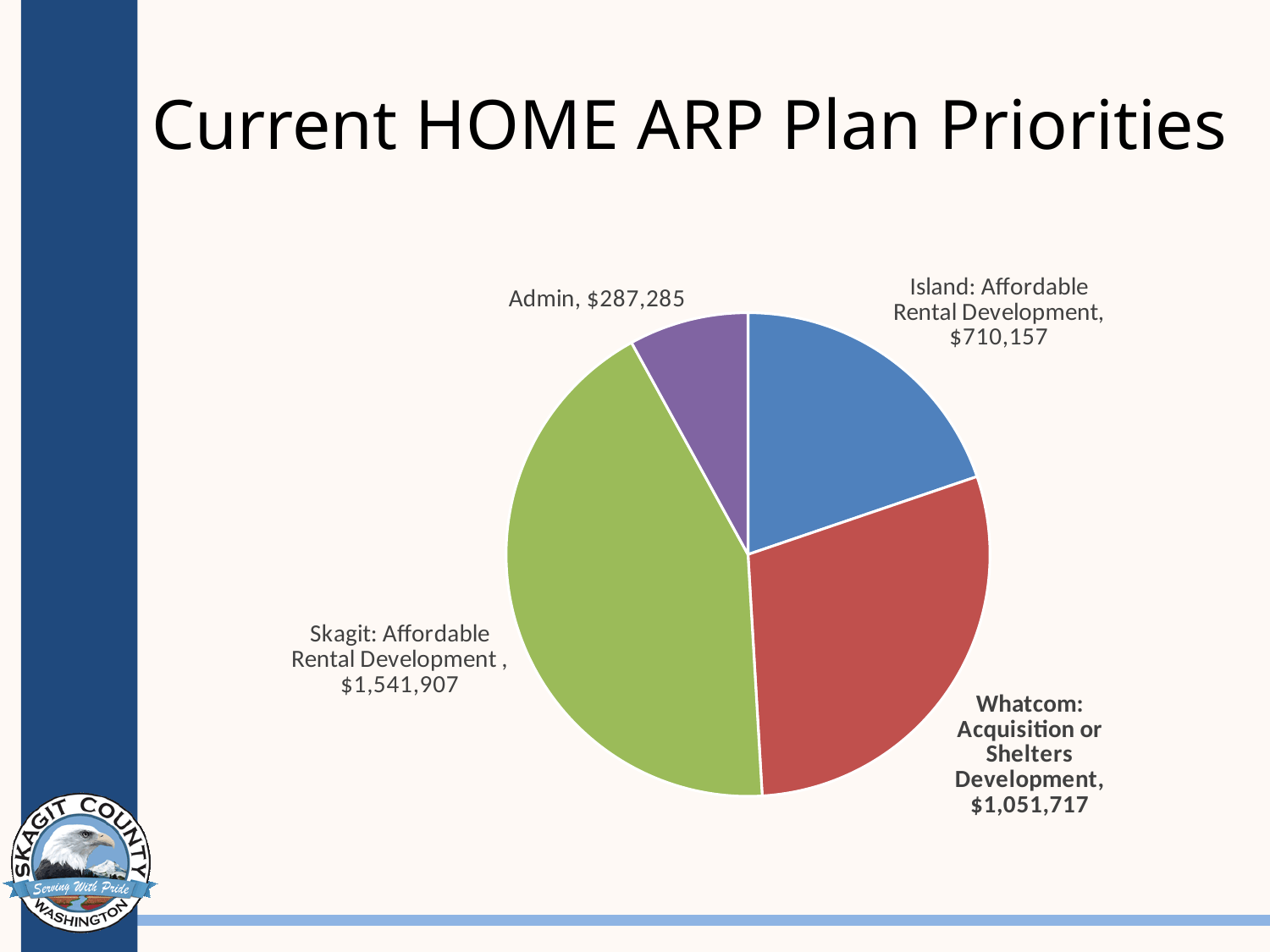
What is the value for Admin in the pie chart? $287,285 What kind of chart is shown on the slide? pie chart Which is larger, the value for Island: Affordable Rental Development or the value for Admin? Island: Affordable Rental Development What is the difference between the Skagit: Affordable Rental Development value and the Whatcom: Acquisition or Shelters Development value? $490,190 Which category has the largest slice of the pie? Skagit: Affordable Rental Development What is the total of all four values in the pie chart? $3,591,066 What is the value for Skagit: Affordable Rental Development? $1,541,907 How many slices does the pie chart have? 4 What is the value for Whatcom: Acquisition or Shelters Development? $1,051,717 What is the value for Island: Affordable Rental Development? $710,157 What colour is the Skagit: Affordable Rental Development slice? green Which category has the smallest slice of the pie? Admin